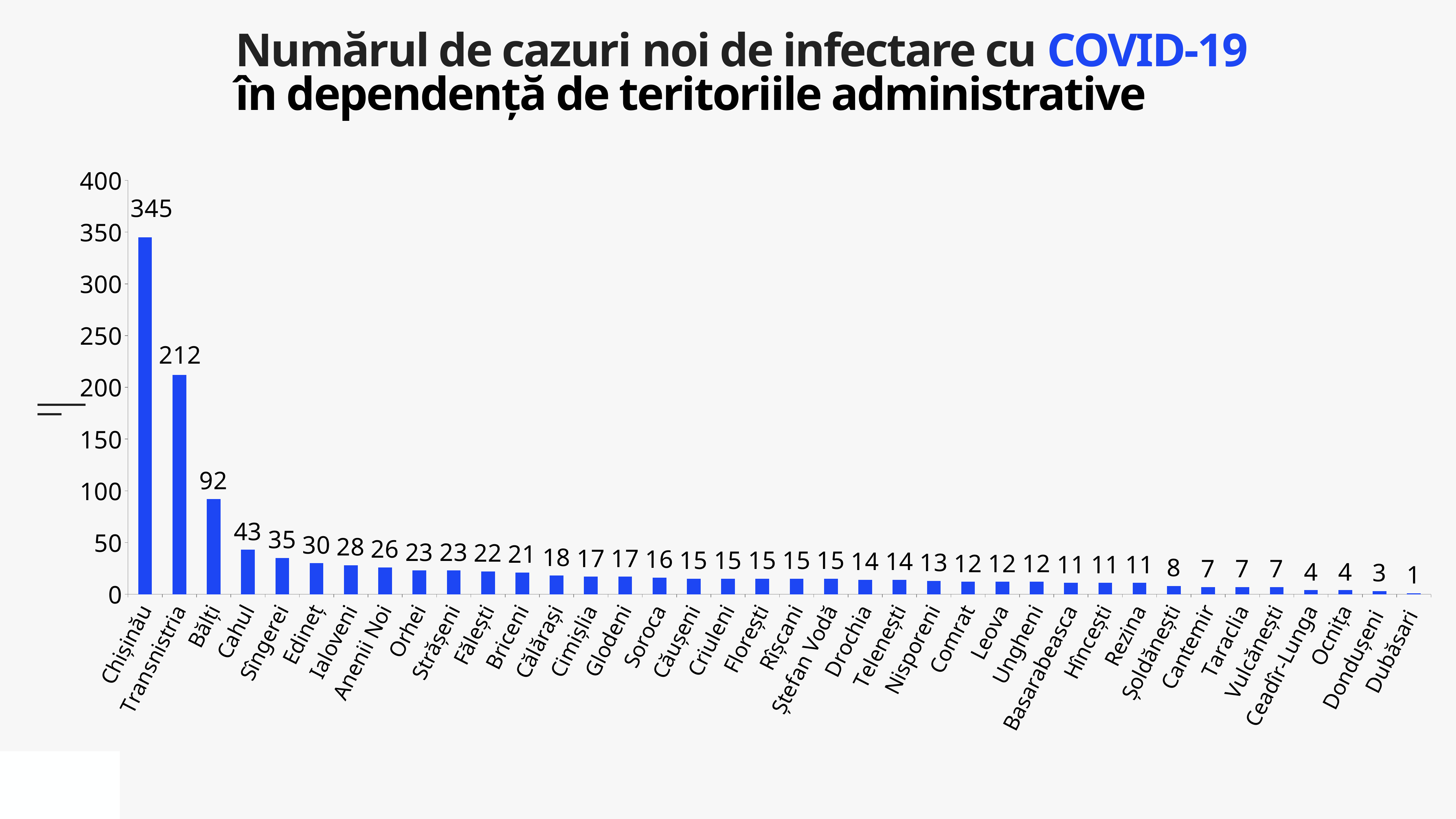
What is the value for Soroca? 16 What is the value for Chișinău? 345 Which territory has the highest number of new cases? Chișinău How many territories are shown on the chart? 38 What is the difference between the values for Chișinău and Transnistria? 133 Is the value for Bălți greater or less than 100? less Do the values rise or fall from left to right along the x axis? fall What kind of chart is shown on the slide? bar chart Which has a larger value, Bălți or Cahul? Bălți What is the value for Cahul? 43 What is the value for Transnistria? 212 Which territory has the lowest number of new cases? Dubăsari